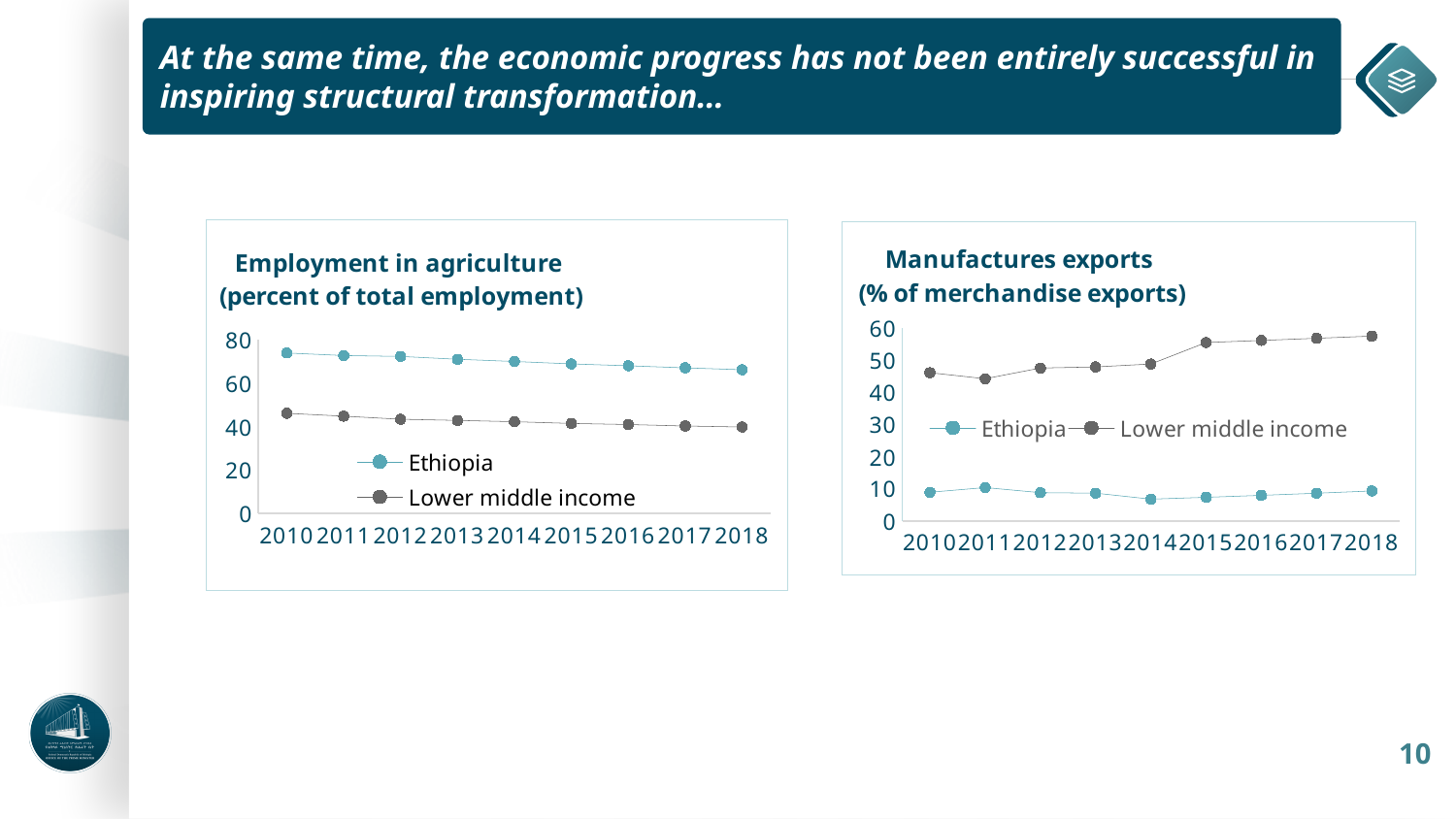
In the "Employment in agriculture" chart, which series is higher in 2018, Ethiopia or Lower middle income? Ethiopia In the "Employment in agriculture" chart, does the Ethiopia line rise or fall from 2010 to 2018? fall In the "Manufactures exports" chart, does the Lower middle income line rise or fall from 2010 to 2018? rise How many series does the legend of the "Employment in agriculture" chart list? 2 In the "Manufactures exports" chart, is the value for Ethiopia in 2018 greater or less than 20? less What kind of chart is the "Manufactures exports" chart? line chart In the "Employment in agriculture" chart, is the value for Ethiopia in 2010 greater or less than 60? greater In the "Manufactures exports" chart, which series is higher in 2015, Ethiopia or Lower middle income? Lower middle income What is the first year shown on the x axis of the "Employment in agriculture" chart? 2010 In the "Manufactures exports" chart, is the value for Lower middle income in 2018 greater or less than 50? greater What kind of chart is the "Employment in agriculture" chart? line chart How many years are plotted on the x axis of the "Manufactures exports" chart? 9